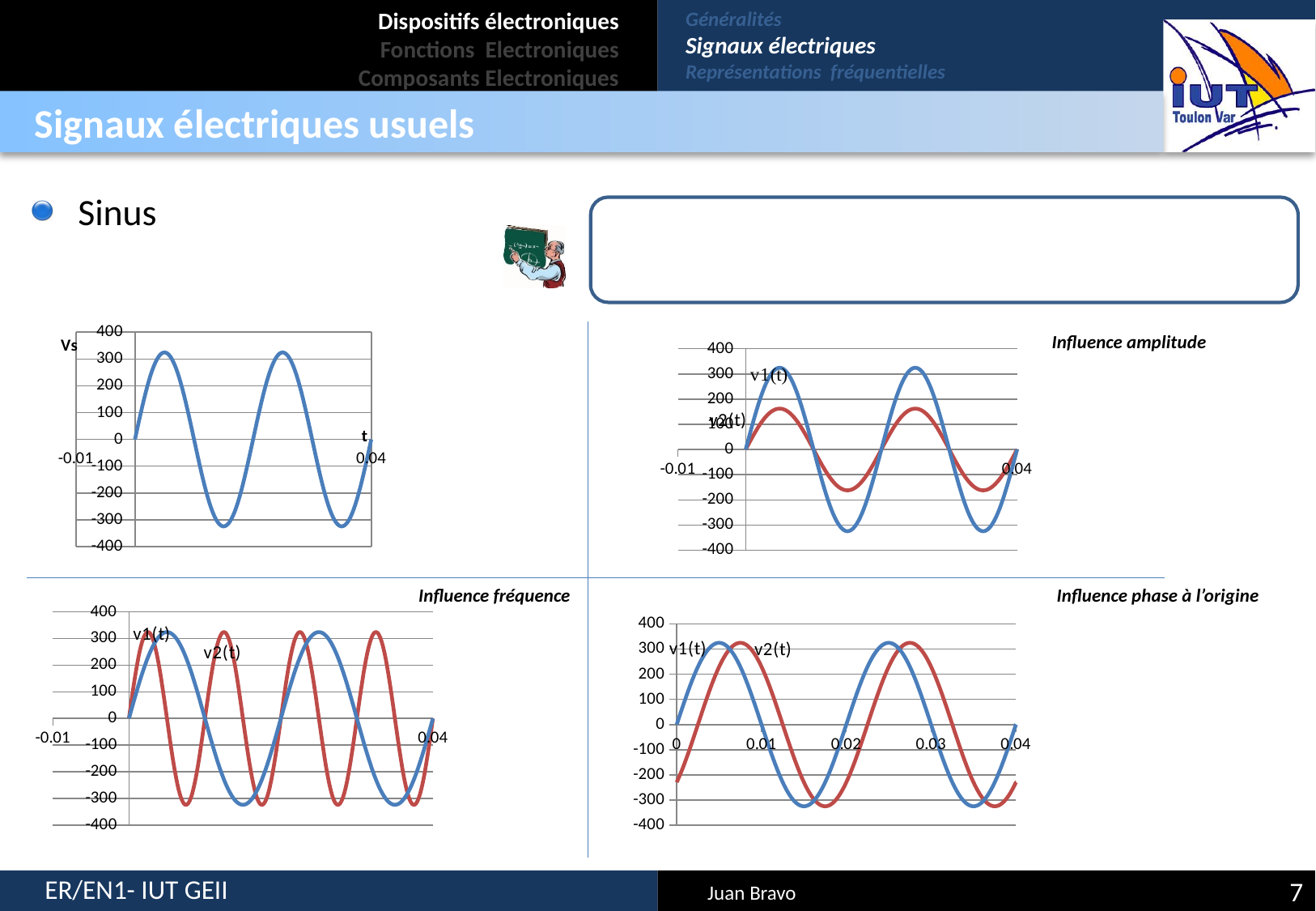
In the chart titled 'Influence fréquence', which series completes more cycles over the plotted time range, v1(t) or v2(t)? v2(t) In the chart titled 'Influence amplitude', which series has the larger peak amplitude, v1(t) or v2(t)? v1(t) What kind of chart is the top-left chart labelled Vs? line chart What is the last tick value shown on the horizontal axis of the chart titled 'Influence phase à l'origine'? 0.04 In the chart titled 'Influence amplitude', how many series are plotted? 2 In the top-left chart labelled Vs, is the minimum value of the signal greater or less than -300? less What is the highest value shown on the vertical axis of the top-left chart labelled Vs? 400 In the chart titled 'Influence phase à l'origine', how many series are plotted? 2 How many charts are shown on the slide? 4 In the chart titled 'Influence amplitude', is the peak value of v1(t) greater or less than 300? greater In the top-left chart labelled Vs, is the peak value of the signal greater or less than 300? greater